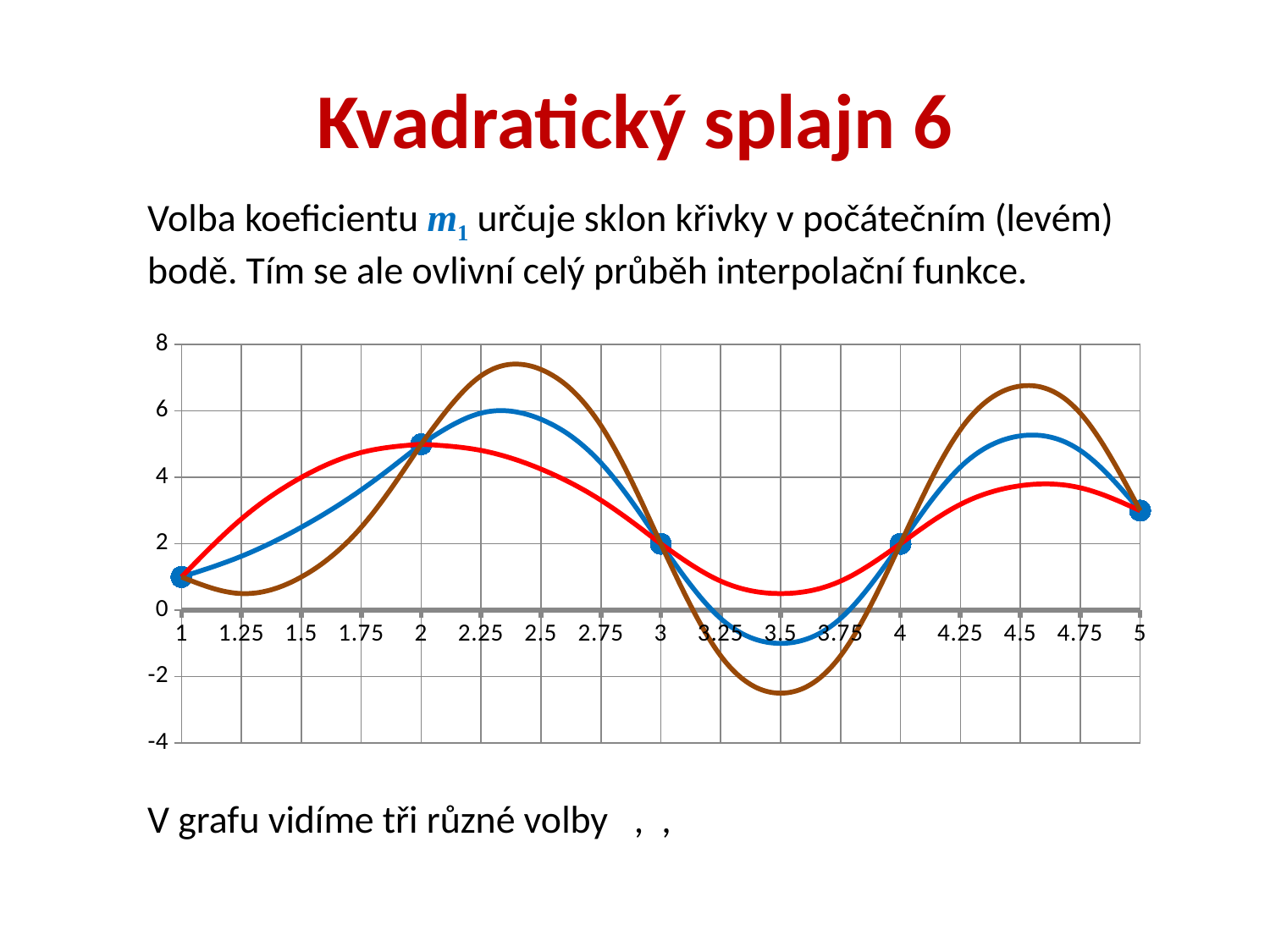
At x = 3.5, which curve has the lowest value? the brown curve How many marked data points (blue dots) are shown on the chart? 5 What is the y value of the marked data point at x = 3? 2 Is the minimum value of the red curve near x = 3.5 greater or less than 0? greater Do the curves rise or fall between x = 3 and x = 3.5? fall Is the peak value of the brown curve between x = 2 and x = 3 greater or less than 6? greater Which curve reaches the highest value on the chart? the brown curve What kind of chart is shown on the slide? line chart How many curves are plotted on the chart? 3 Is the value of the blue curve at x = 3.5 greater or less than 0? less What is the y value of the marked data point at x = 4? 2